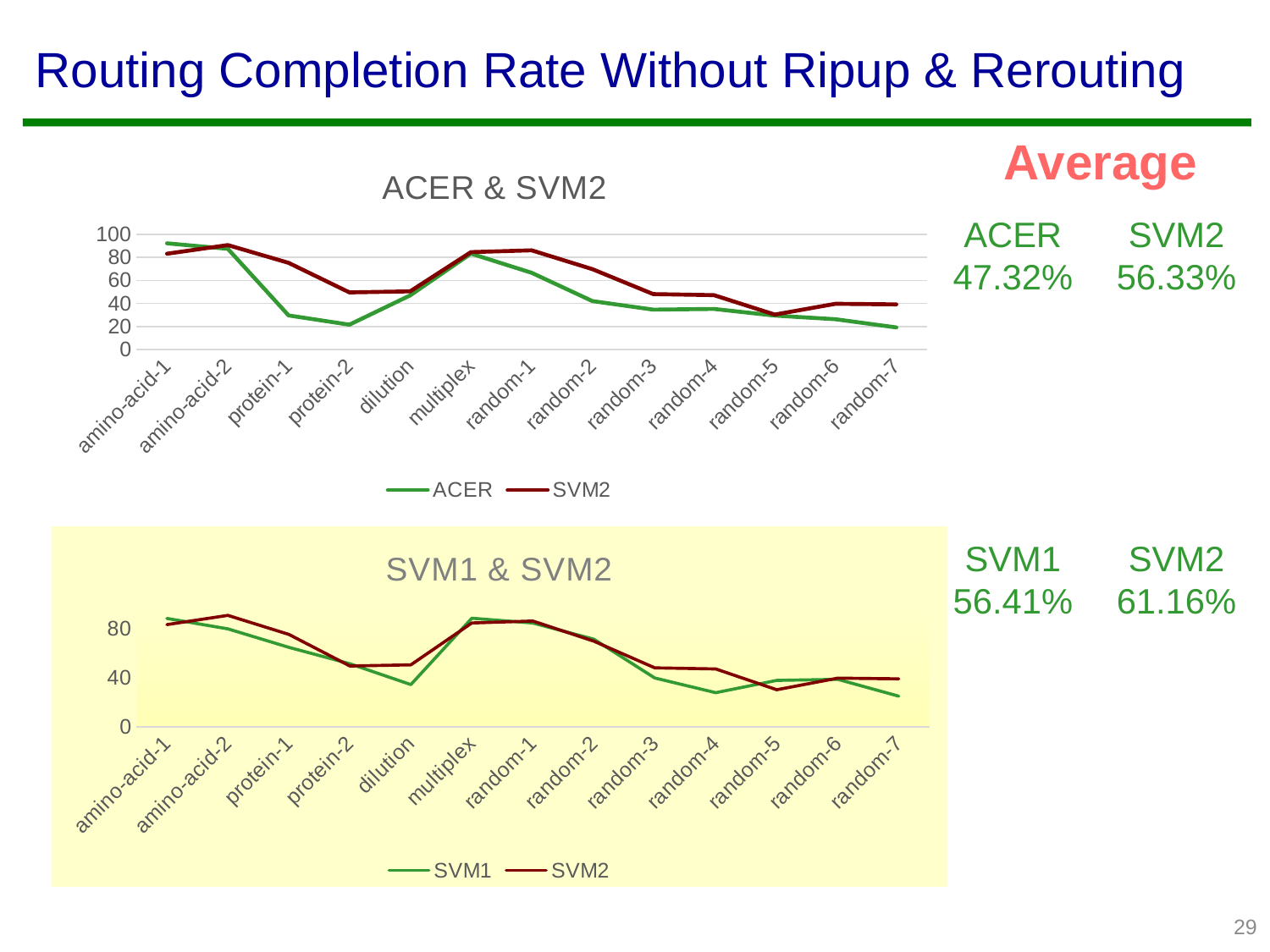
How many series does the legend of the bottom chart "SVM1 & SVM2" list? 2 In the top chart "ACER & SVM2", is the ACER value for random-7 greater or less than 40? less In the bottom chart "SVM1 & SVM2", is the SVM1 value for dilution greater or less than 40? less In the top chart "ACER & SVM2", does the ACER line rise or fall from random-1 to random-7? fall What kind of chart is the top chart titled "ACER & SVM2"? line chart In the bottom chart "SVM1 & SVM2", which series has the larger value at random-4, SVM1 or SVM2? SVM2 In the top chart "ACER & SVM2", which series has the larger value at protein-1, ACER or SVM2? SVM2 In the top chart "ACER & SVM2", is the ACER value for protein-2 greater or less than 40? less How many categories are plotted along the x axis of the top chart "ACER & SVM2"? 13 What are the two series named in the legend of the top chart? ACER and SVM2